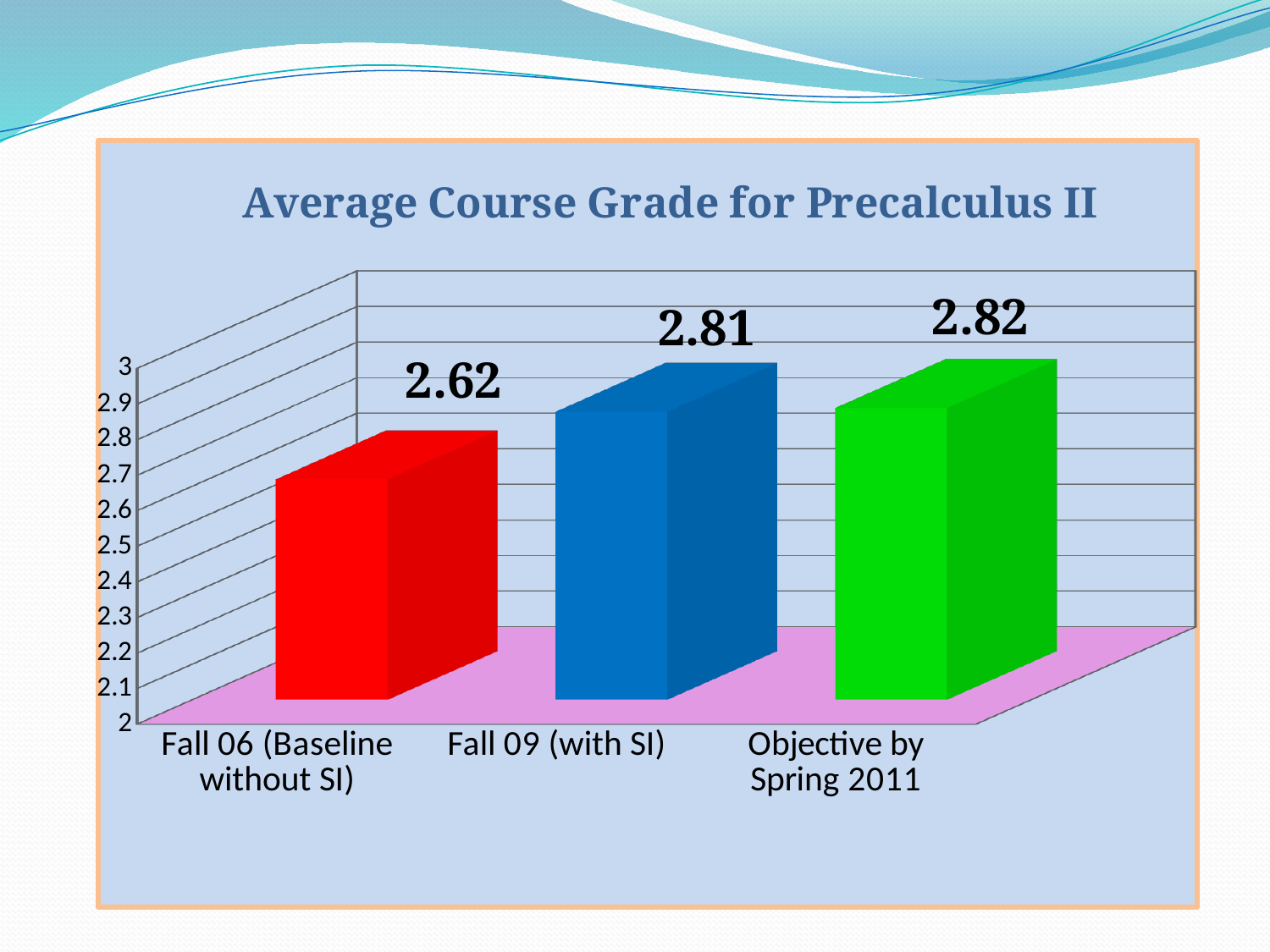
Which is larger, the value for Fall 06 (Baseline without SI) or the value for Fall 09 (with SI)? Fall 09 (with SI) How many categories are shown in the chart? 3 What is the title of the chart? Average Course Grade for Precalculus II Is the value for Fall 06 (Baseline without SI) greater or less than 2.7? less What is the difference between the Fall 09 (with SI) grade and the Fall 06 (Baseline without SI) grade? 0.19 What is the value for Objective by Spring 2011? 2.82 What kind of chart is shown on the slide? bar chart What is the average course grade for Fall 09 (with SI)? 2.81 Which category has the lowest average course grade? Fall 06 (Baseline without SI) Do the values rise or fall from left to right across the categories? rise What is the average course grade for Fall 06 (Baseline without SI)? 2.62 What is the difference between the Objective by Spring 2011 value and the Fall 09 (with SI) value? 0.01